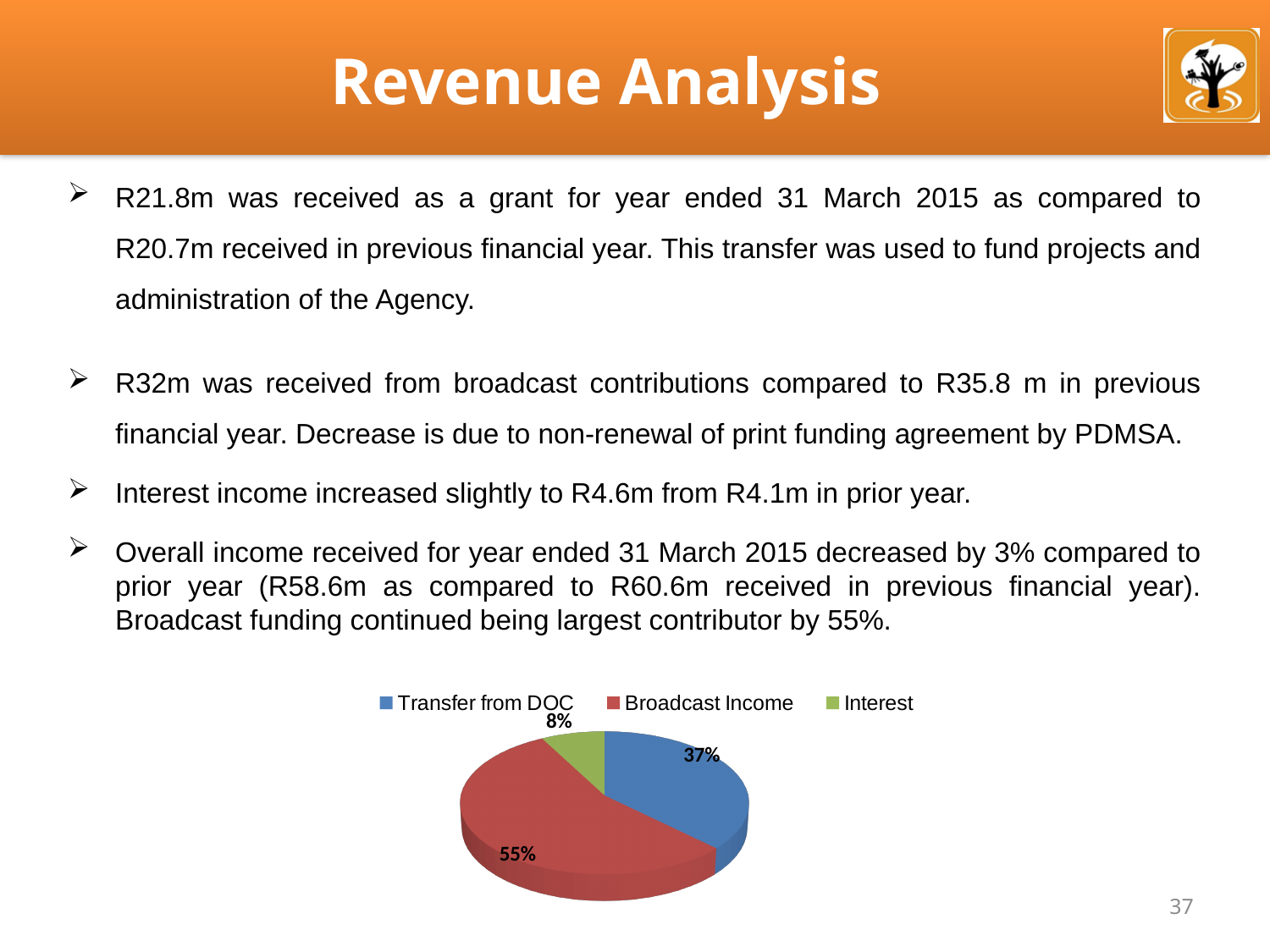
What share of the pie does Transfer from DOC represent? 37% How many entries does the legend list? 3 What is the difference in percentage points between Broadcast Income and Transfer from DOC? 18 What colour is the Broadcast Income slice? red What share of the pie does Interest represent? 8% Which category has the smallest slice of the pie? Interest What kind of chart is shown on the slide? pie chart Which is larger, the share for Transfer from DOC or the share for Interest? Transfer from DOC What share of the pie does Broadcast Income represent? 55% Which category has the largest slice of the pie? Broadcast Income What colour is the Interest slice? green How many slices does the pie chart have? 3